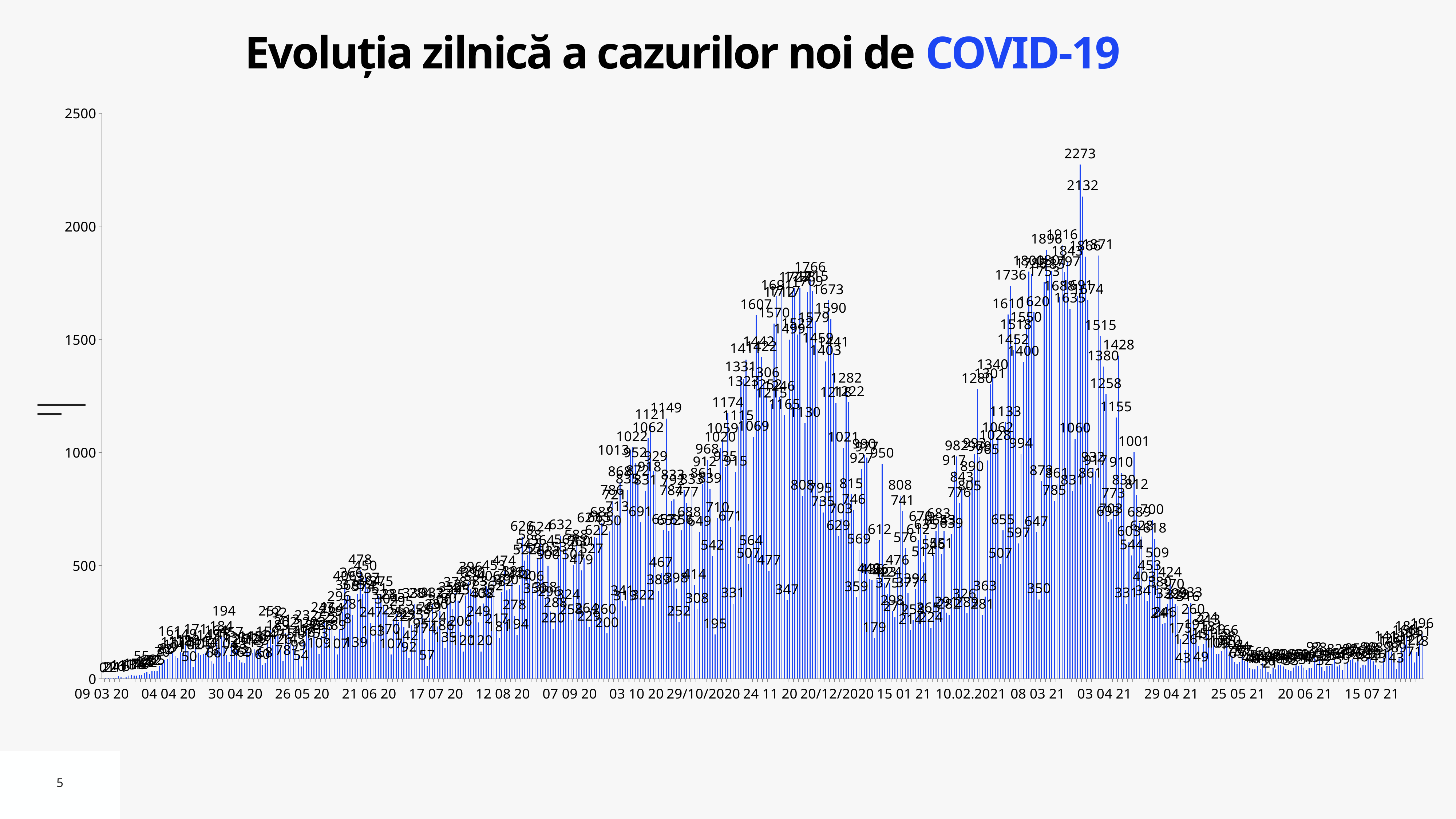
What is the highest value labelled on the chart? 2273 What kind of chart is shown on the slide? bar chart What is the second-highest value labelled on the chart, just below the 2273 peak? 2132 What is the title of the chart? Evoluția zilnică a cazurilor noi de COVID-19 What is the highest value labelled in the wave around 24 11 20 to 20/12/2020? 1766 Which wave reaches a higher peak: the one around 03 04 21 or the one around 20/12/2020? the one around 03 04 21 What is the highest tick value shown on the y axis? 2500 Do the values rise or fall along the x axis between 03 04 21 and 20 06 21? fall Is the highest bar on the chart greater or less than 2000? greater What is the first date label shown on the x axis? 09 03 20 What is the difference between the two highest labelled values, 2273 and 2132? 141 Are the bars around 20 06 21 greater or less than 500? less